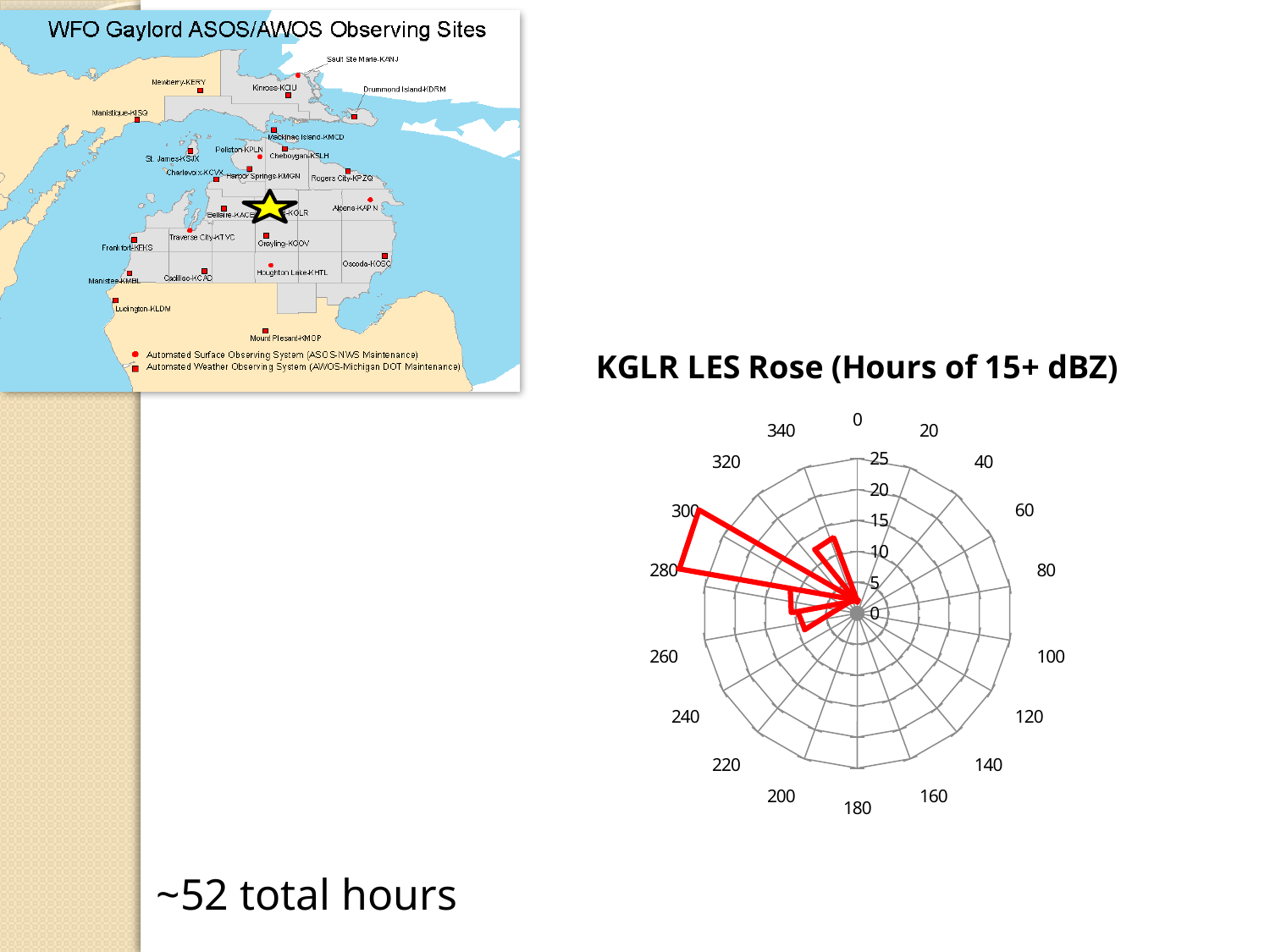
How many direction categories are plotted around the KGLR LES Rose chart? 18 What is the title of the chart on the slide? KGLR LES Rose (Hours of 15+ dBZ) What is the highest value labelled on the radial axis of the KGLR LES Rose chart? 25 Is the value for the 180 direction greater or less than 5? less Is the value for the 100 direction greater or less than 5? less What kind of chart is the KGLR LES Rose chart? radar chart Which direction has the larger value, 280 or 320? 280 Is the value for the 260 direction greater or less than 15? less Which direction has the larger value, 300 or 260? 300